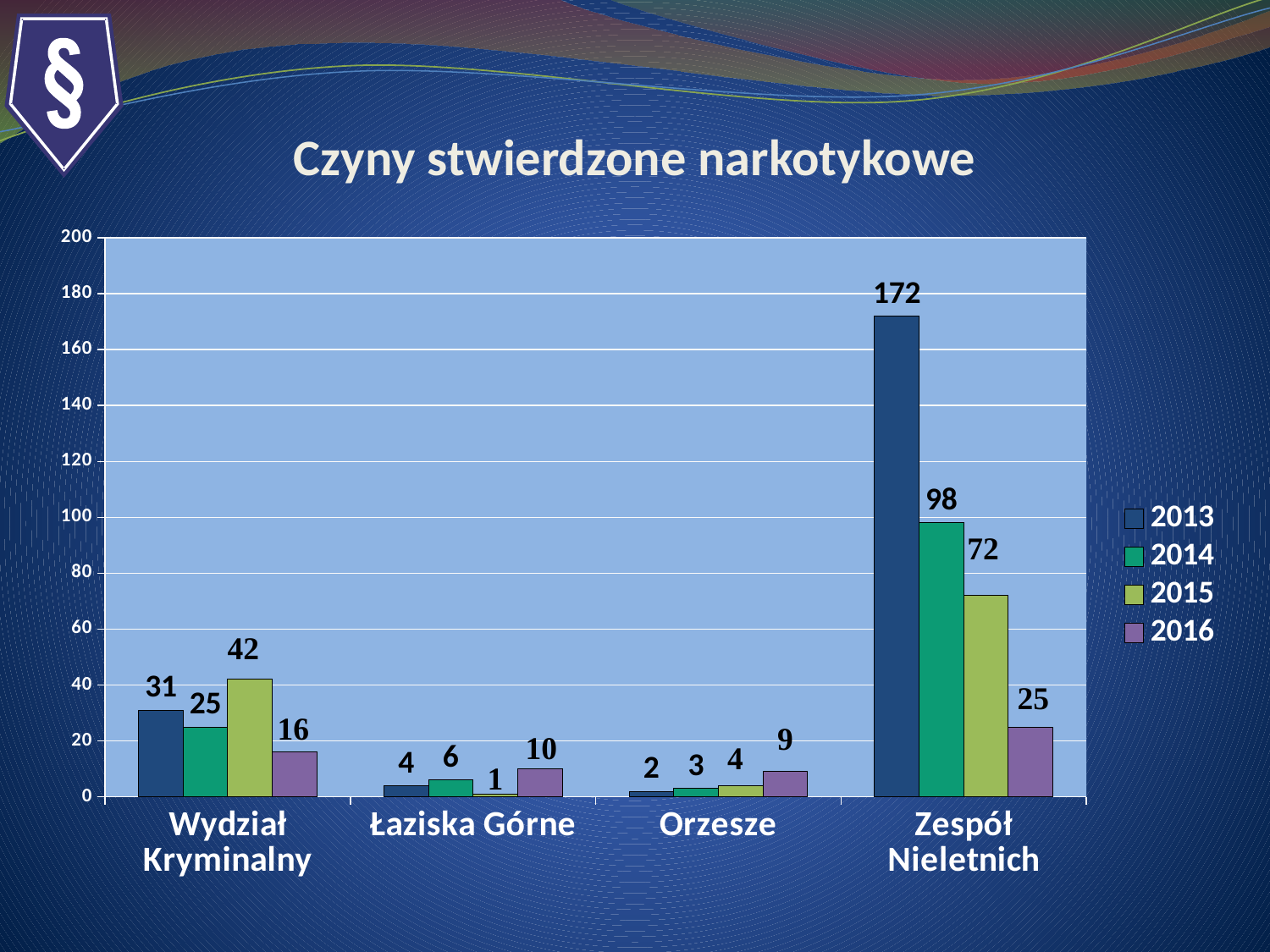
Which category has the highest value in 2013? Zespół Nieletnich What is the value for Łaziska Górne in 2016? 10 What is the value for Orzesze in 2014? 3 How many series does the legend list? 4 Which is larger: the 2015 value for Wydział Kryminalny or the 2016 value for Zespół Nieletnich? Wydział Kryminalny 2015 What is the difference between the 2013 and 2014 values for Zespół Nieletnich? 74 Which category has the lowest value in 2015? Łaziska Górne What is the value for Wydział Kryminalny in 2015? 42 What is the title of the chart? Czyny stwierdzone narkotykowe What kind of chart is shown on the slide? Bar chart What is the value for Zespół Nieletnich in 2013? 172 How many categories are shown on the x axis? 4